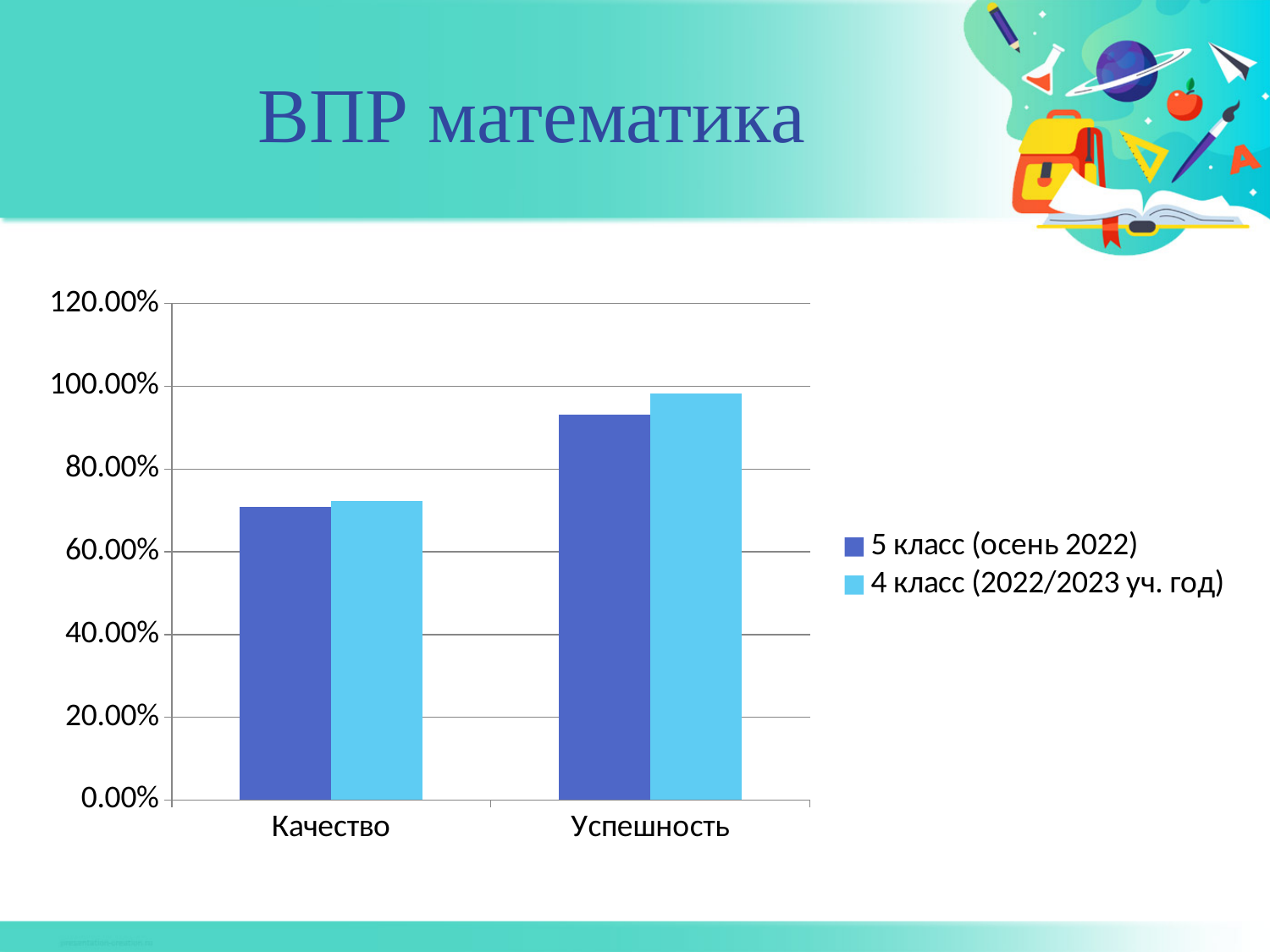
Is the value for Качество in the 5 класс (осень 2022) series greater or less than 60.00%? greater How many categories are shown on the x axis of the chart? 2 Is the value for Успешность in the 5 класс (осень 2022) series greater or less than 80.00%? greater Which series is shown in the darker blue colour in the chart? 5 класс (осень 2022) Which category has the higher values in the chart, Качество or Успешность? Успешность Is the value for Успешность in the 4 класс (2022/2023 уч. год) series greater or less than 100.00%? less What kind of chart is shown on the slide? bar chart For Успешность, which series has the larger value, 5 класс (осень 2022) or 4 класс (2022/2023 уч. год)? 4 класс (2022/2023 уч. год) Which bar is the tallest in the chart? 4 класс (2022/2023 уч. год) for Успешность How many series does the chart legend list? 2 What is the title of the slide containing the chart? ВПР математика